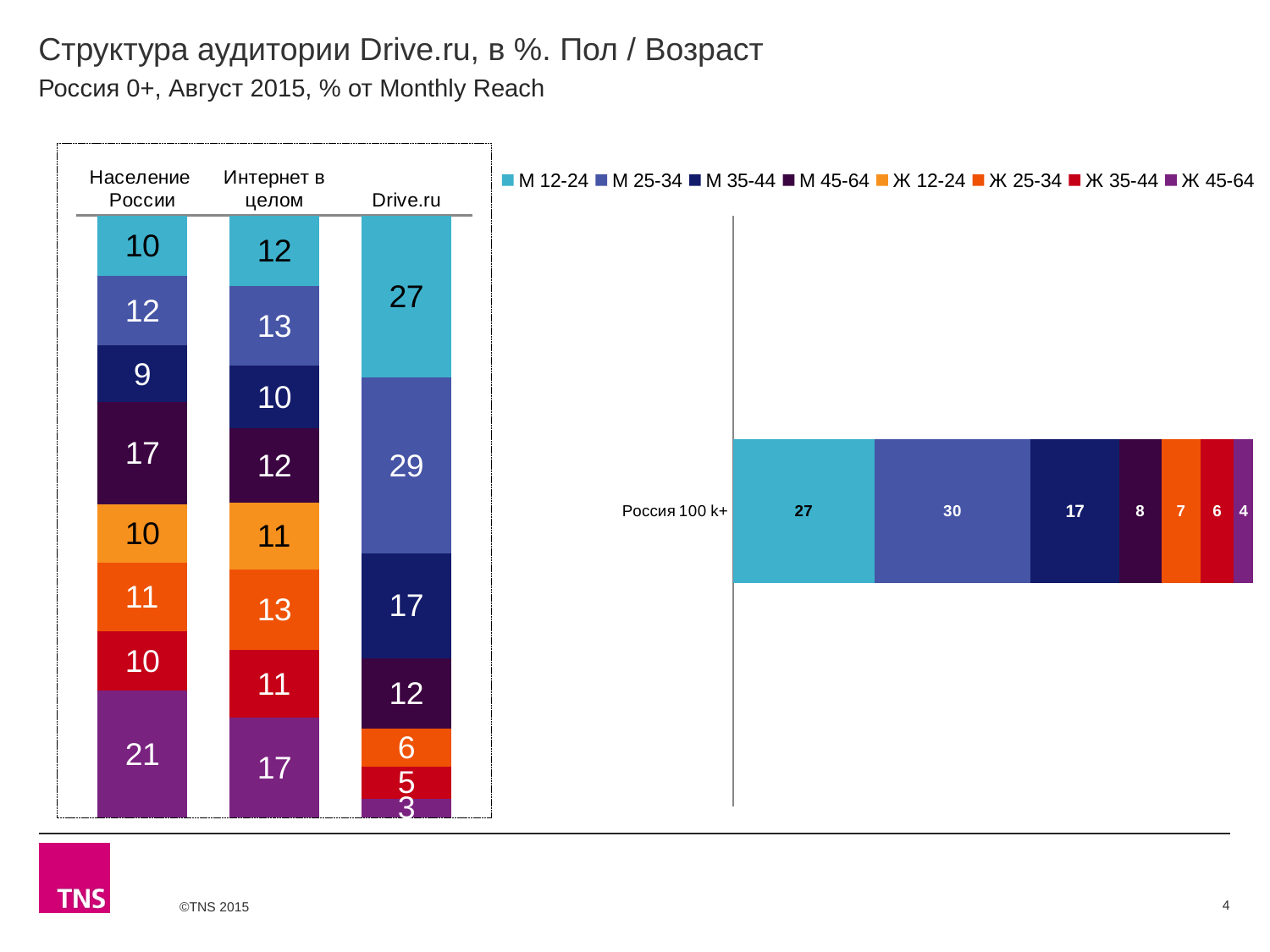
In the left chart, what is the difference between the Ж 45-64 values for Население России and Интернет в целом? 4 In the left chart, which is larger for М 45-64: Население России or Drive.ru? Население России What kind of chart is the right chart (Россия 100 k+)? Stacked bar chart In the right chart (Россия 100 k+), what is the difference between the М 12-24 and М 35-44 values? 10 In the right chart (Россия 100 k+), what is the value for М 25-34? 30 In the left chart, how many columns (audience groups) are shown? 3 In the left chart, what is the value for М 12-24 in the Drive.ru column? 27 In the left chart, which column has the largest М 25-34 segment? Drive.ru In the left chart, what is the value for Ж 45-64 in the Население России column? 21 In the right chart (Россия 100 k+), which series has the largest segment? М 25-34 In the left chart, what is the value for Ж 12-24 in the Интернет в целом column? 11 How many series does the legend on the right list? 8